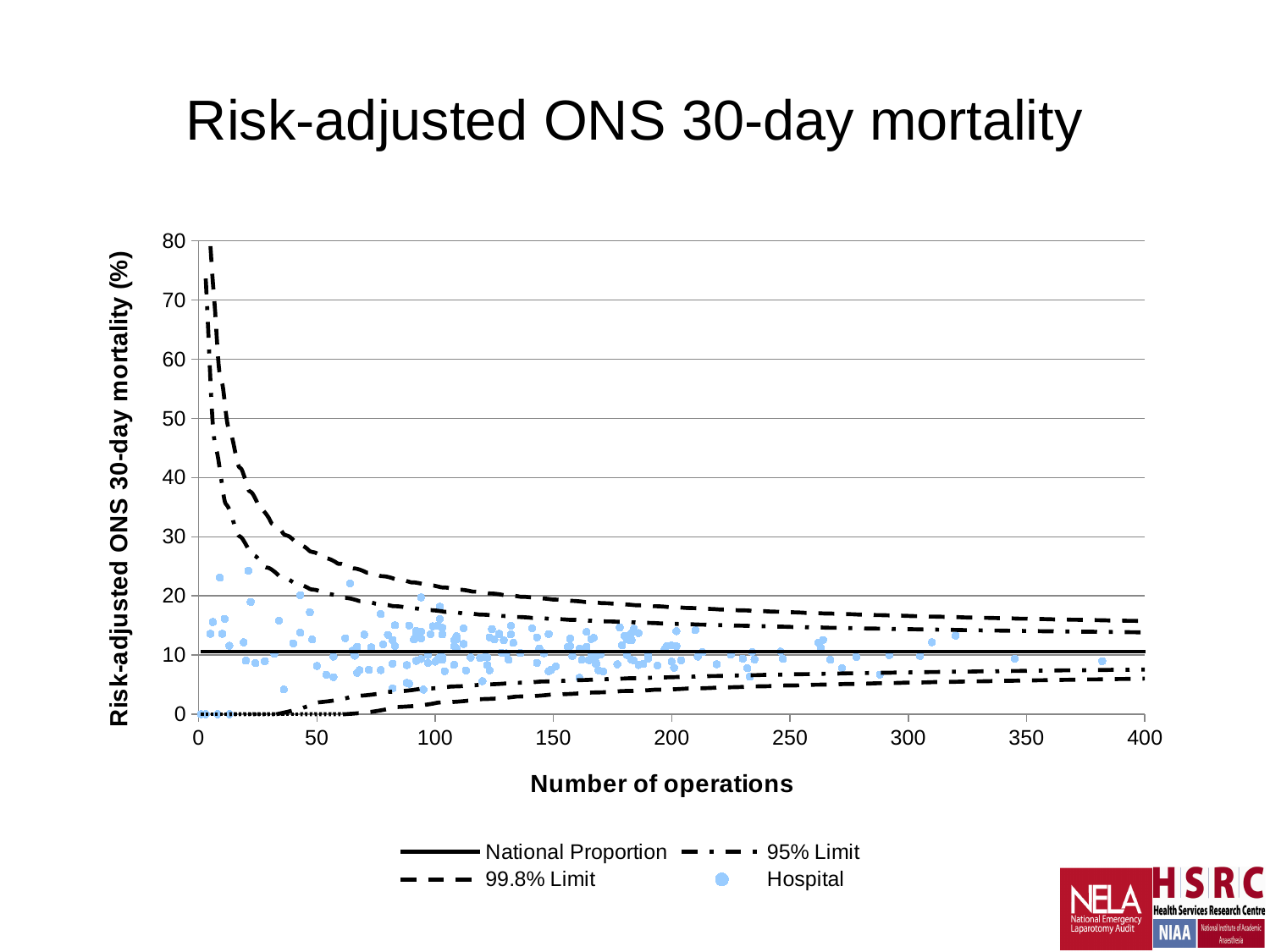
Is the upper 95% Limit at 400 operations greater or less than 10? greater Does the upper 99.8% Limit line rise or fall as the number of operations increases? Fall Which series is plotted as light blue dots? Hospital Does the lower 95% Limit line rise or fall as the number of operations increases? Rise Is the National Proportion line greater or less than 20? less What is the title of the chart? Risk-adjusted ONS 30-day mortality Is the lower 99.8% Limit at 400 operations greater or less than 10? less What kind of chart is shown on the slide? Scatter chart What is the label of the x axis? Number of operations How many series does the legend list? 4